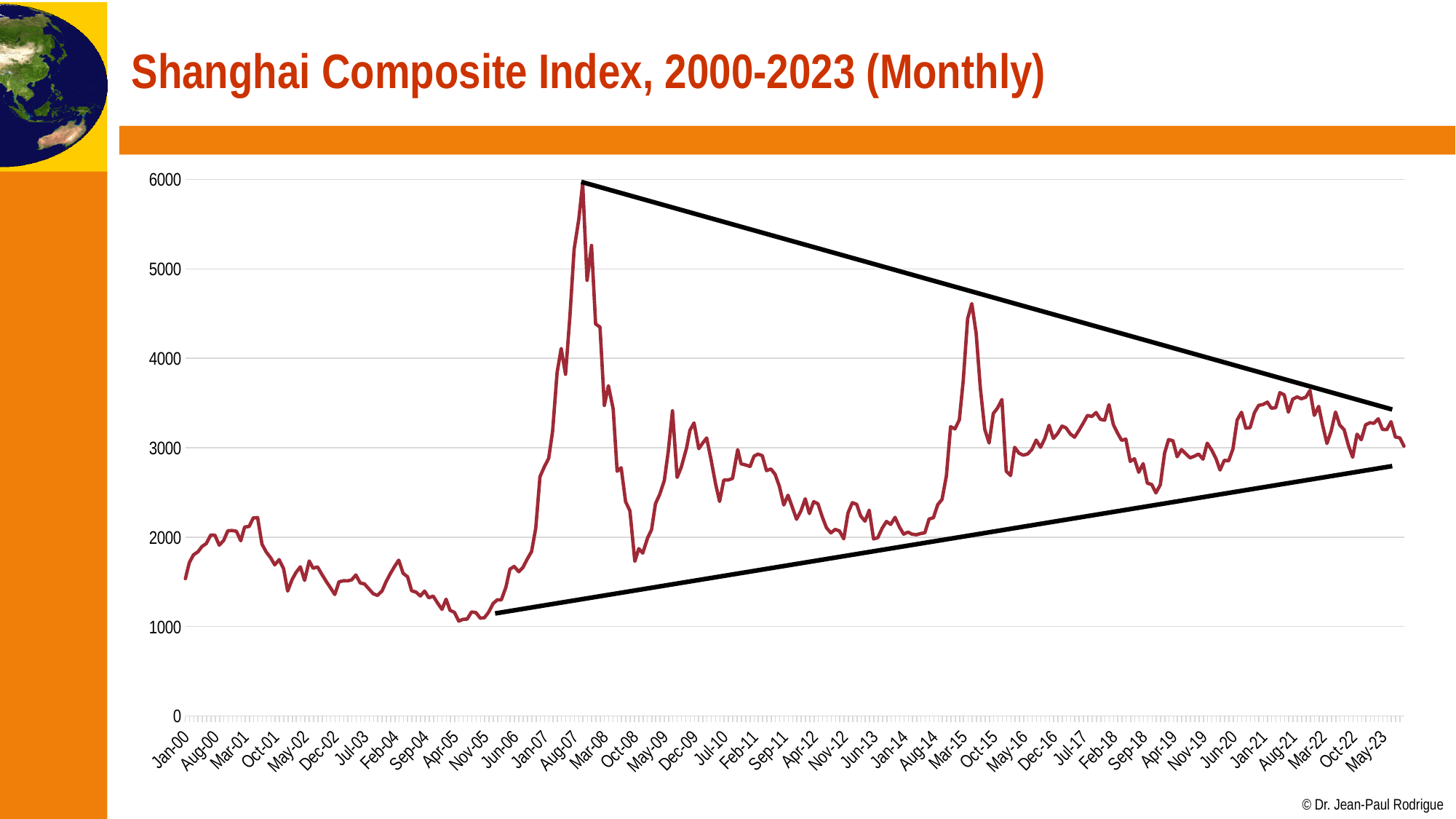
What is the title of the chart? Shanghai Composite Index, 2000-2023 (Monthly) Is the peak value reached in 2007 greater or less than 5000? greater Is the value for Jan-00 greater or less than 2000? less Is the value for Jan-21 greater or less than 3000? greater Does the index rise or fall overall between Jan-00 and Apr-05? fall In which year does the Shanghai Composite Index reach its highest value on the chart? 2007 What kind of chart is shown on the slide? line chart Which is larger, the peak value in 2007 or the peak value in 2015? the peak in 2007 What is the highest value shown on the vertical axis? 6000